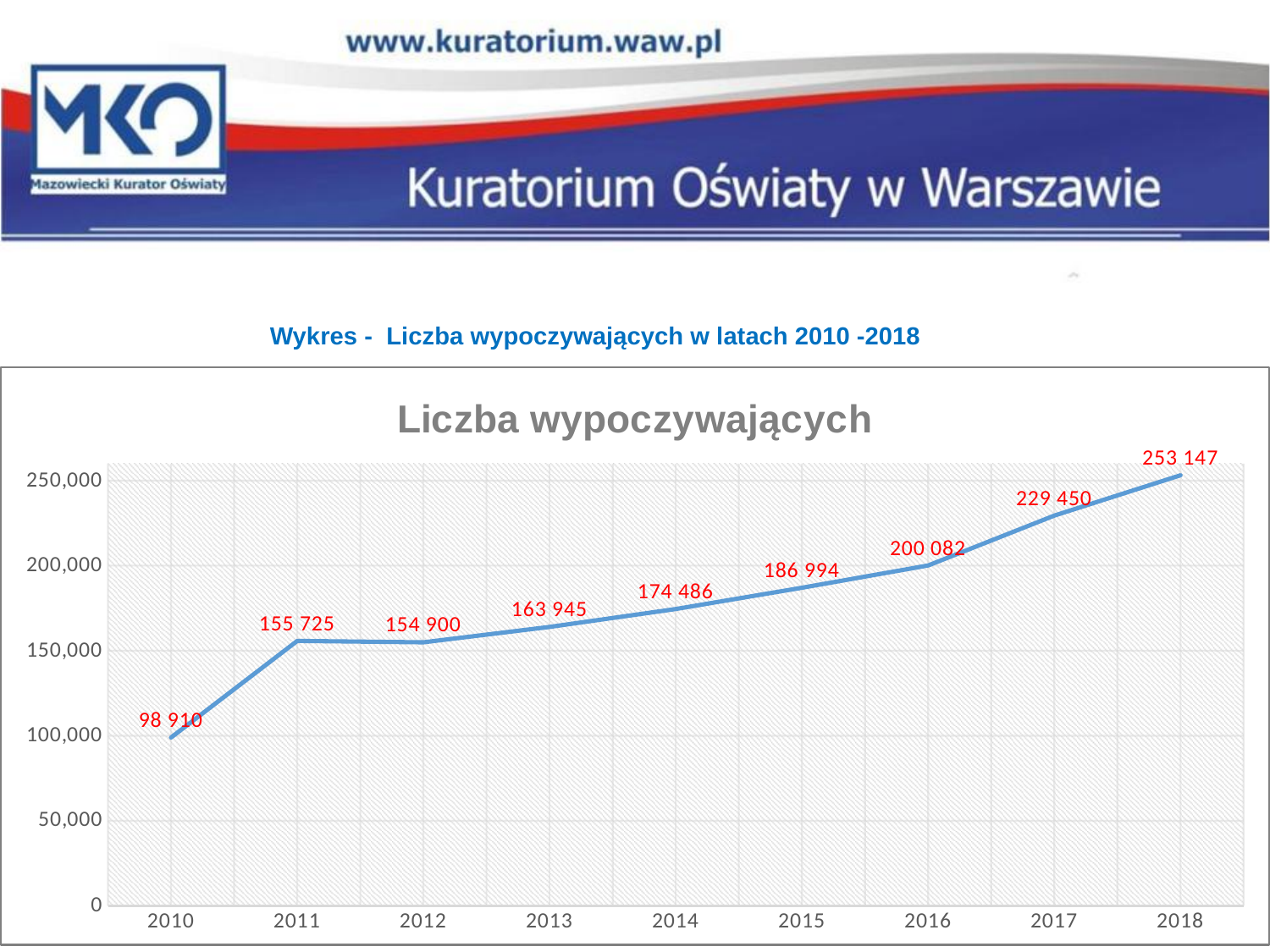
What type of chart is shown on the slide? line chart Which is larger, the value for 2011 or the value for 2012? 2011 What is the value for 2017? 229 450 How many years are plotted on the x axis? 9 What is the value for 2014? 174 486 Is the value for 2016 greater or less than 150,000? greater What is the difference between the values for 2011 and 2010? 56 815 Which year has the highest value? 2018 What is the title of the chart? Liczba wypoczywających What is the value for 2010? 98 910 Which year has the lowest value? 2010 What is the difference between the values for 2018 and 2017? 23 697